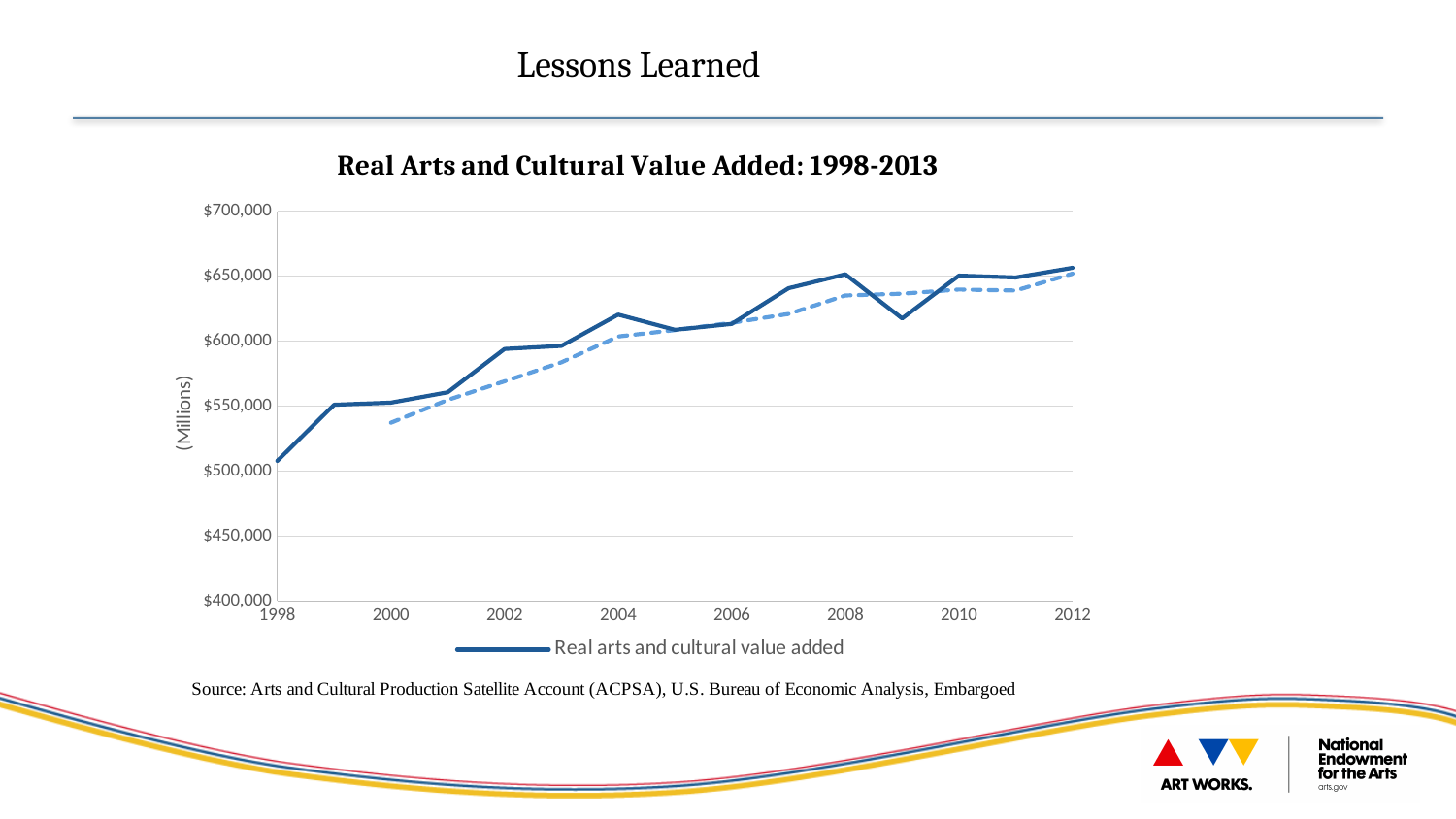
How many series does the chart legend list? 1 Is the value for 2009 greater or less than $650,000? less Is the value for 1998 greater or less than $550,000? less How many year labels are shown on the x axis? 8 Is the value for 2004 greater or less than $600,000? greater Which year has the larger real arts and cultural value added, 2008 or 2009? 2008 Which year has the lowest real arts and cultural value added? 1998 Does the real arts and cultural value added generally rise or fall from 1998 to 2012? Rise What is the title of the chart? Real Arts and Cultural Value Added: 1998-2013 What kind of chart is shown on the slide? Line chart What is the name of the series shown in the legend? Real arts and cultural value added